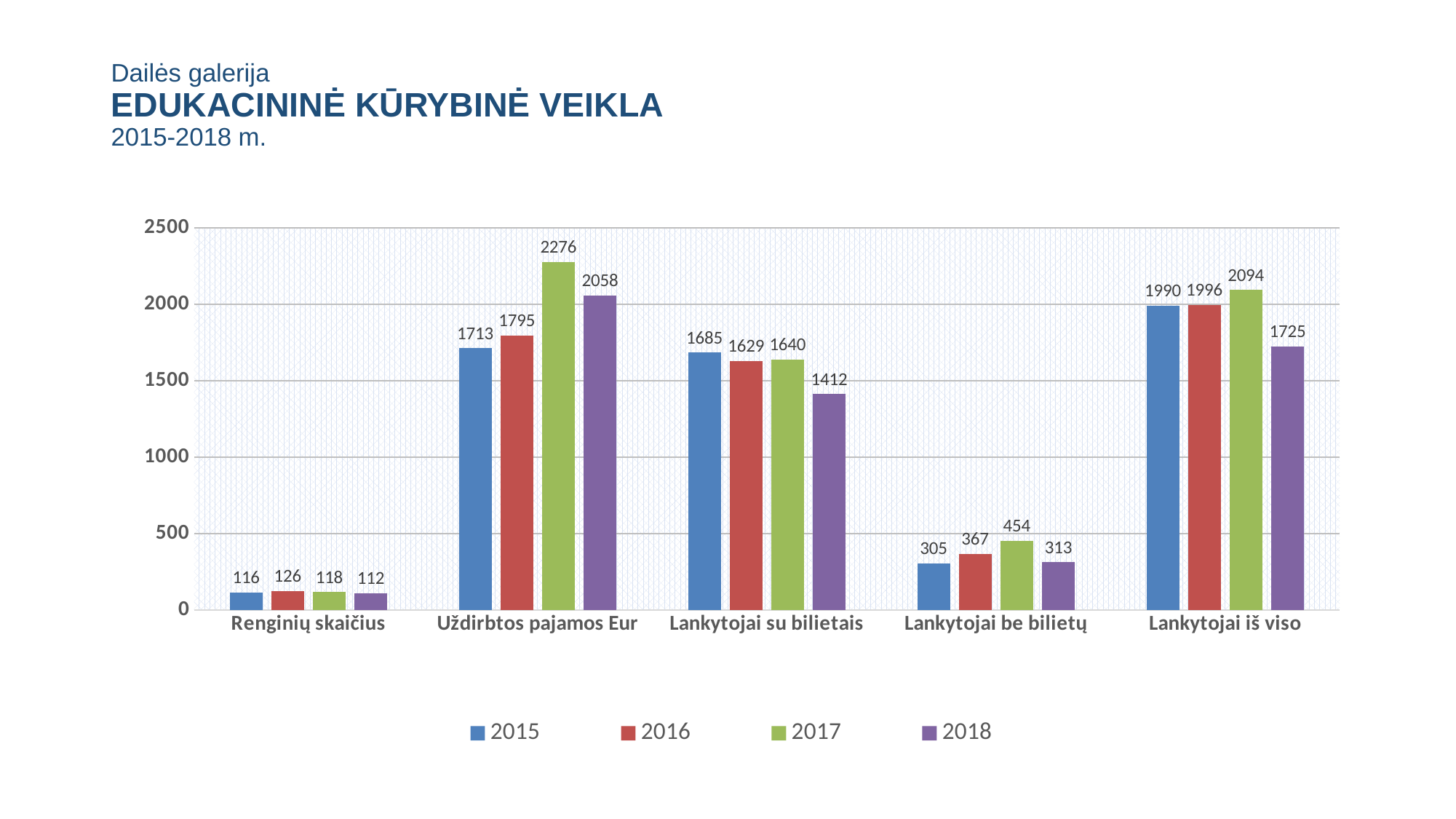
What is the value for 2015 in the Renginių skaičius category? 116 How many categories are shown on the x axis? 5 What is the value for 2017 in the Uždirbtos pajamos Eur category? 2276 Which year has the highest value in the Lankytojai be bilietų category? 2017 How many series does the legend list? 4 Which year has the lowest value in the Lankytojai iš viso category? 2018 Is the value for 2017 in the Lankytojai iš viso category greater or less than 2000? greater What kind of chart is shown on the slide? Bar chart What is the value for 2018 in the Lankytojai su bilietais category? 1412 What is the difference between the 2017 and 2018 values in the Uždirbtos pajamos Eur category? 218 Which is larger in the Lankytojai su bilietais category: the 2015 value or the 2016 value? 2015 Which colour represents the 2018 series in the legend? Purple